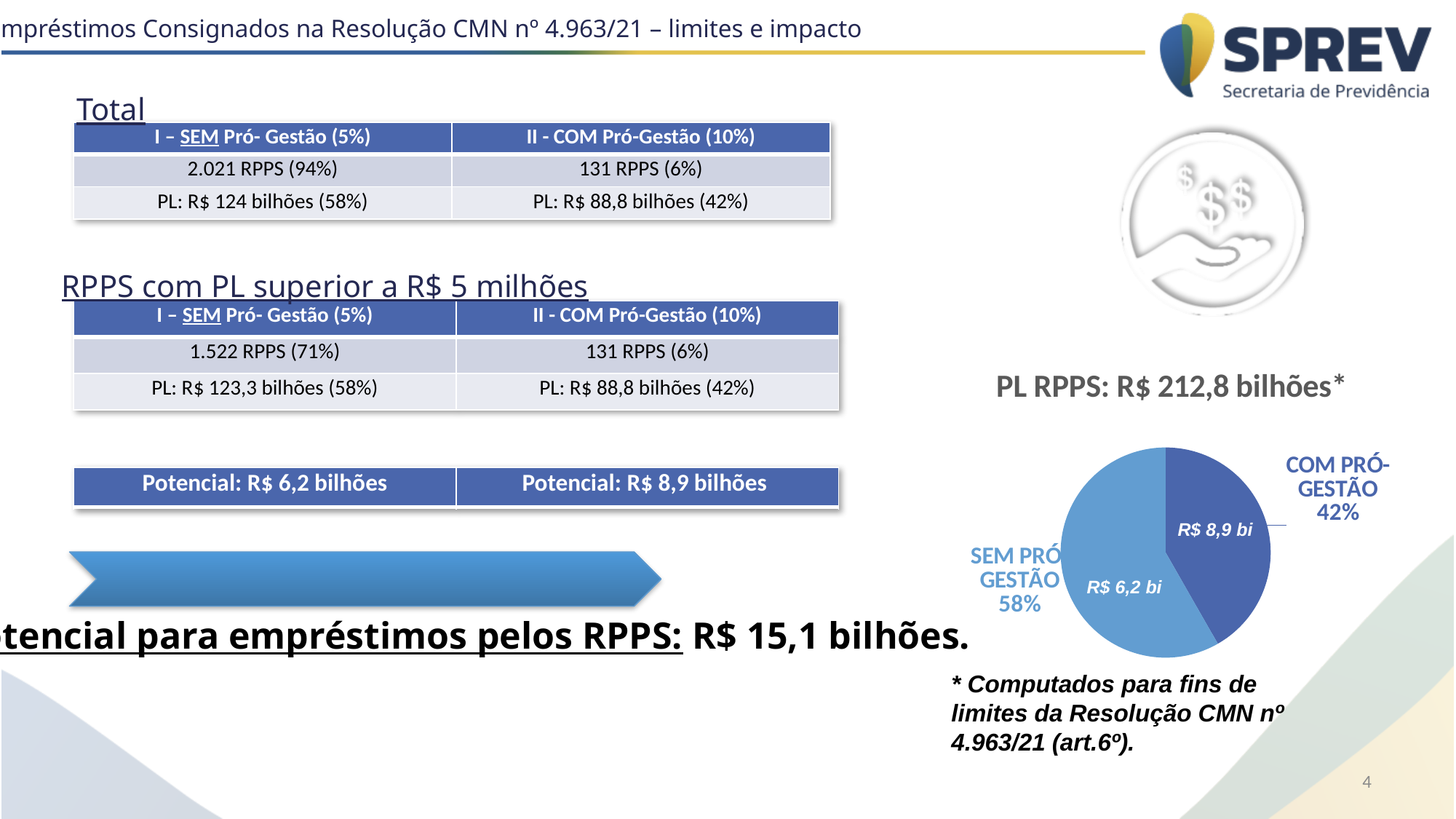
Which slice of the pie chart has the smaller percentage share? COM PRÓ-GESTÃO Which slice of the pie chart is drawn in the darker blue? COM PRÓ-GESTÃO What percentage share of the pie is labelled for COM PRÓ-GESTÃO? 42% What is the sum of the two values labelled on the pie chart slices? R$ 15,1 bi What percentage share of the pie is labelled for SEM PRÓ GESTÃO? 58% How many slices does the pie chart have? 2 What value is labelled on the COM PRÓ-GESTÃO slice of the pie chart? R$ 8,9 bi What kind of chart is shown on the slide? pie chart Which slice of the pie chart has the larger percentage share? SEM PRÓ GESTÃO What value is labelled on the SEM PRÓ GESTÃO slice of the pie chart? R$ 6,2 bi Which slice carries the larger labelled value in R$ bi, SEM PRÓ GESTÃO or COM PRÓ-GESTÃO? COM PRÓ-GESTÃO What is the difference between the labelled values of the COM PRÓ-GESTÃO and SEM PRÓ GESTÃO slices? R$ 2,7 bi